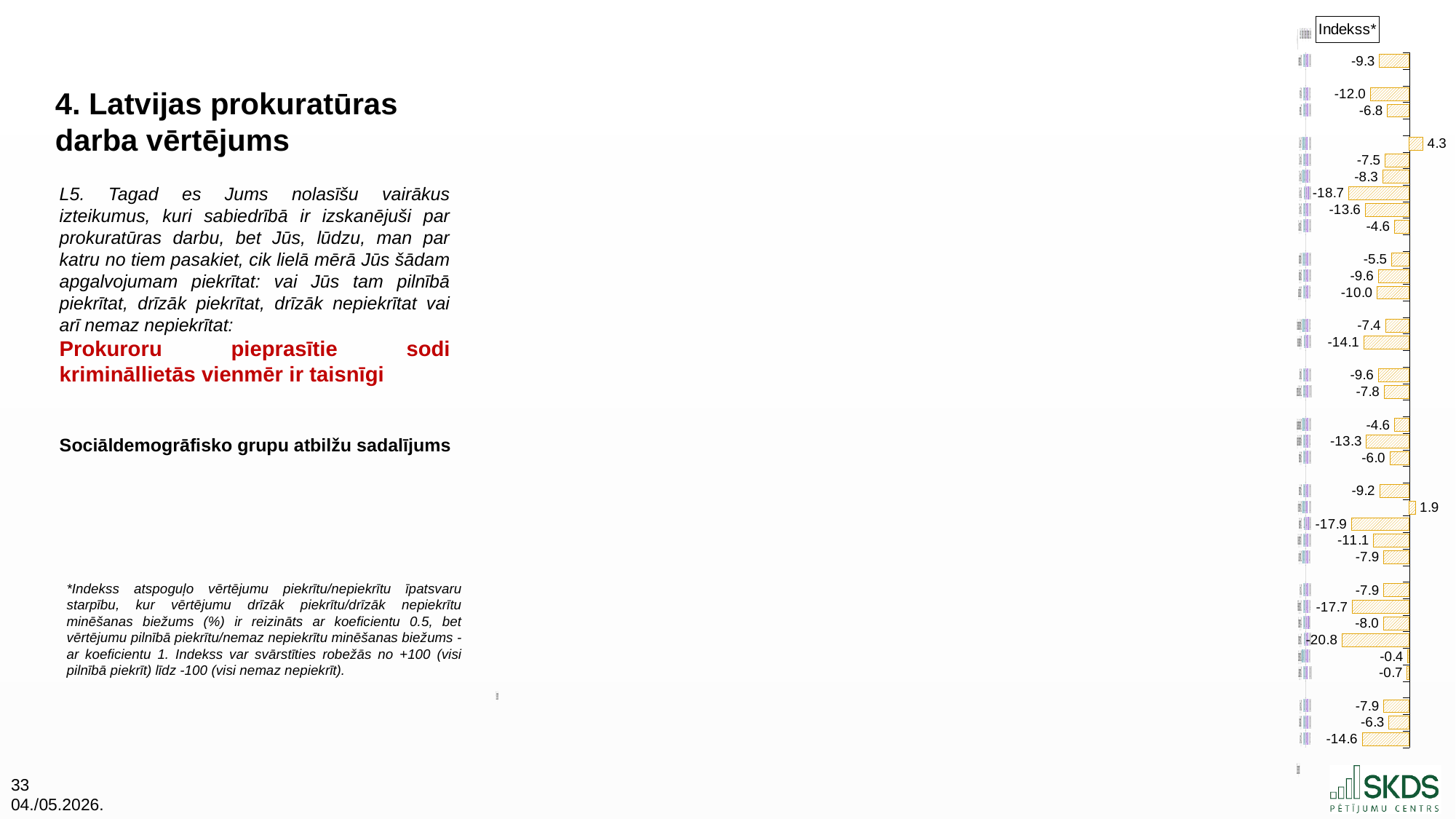
What is the highest index value shown in the chart? 4.3 Which is larger, the index value of the topmost bar (-9.3) or the bottommost bar (-14.6)? the topmost bar (-9.3) What is the lowest index value shown in the chart? -20.8 What is the index value of the topmost bar in the chart? -9.3 What is the second positive index value shown in the chart, below 4.3? 1.9 What kind of chart is shown on the right side of the slide? bar chart What is the title shown above the chart on the right? Indekss* What is the difference between the highest index value (4.3) and the lowest index value (-20.8) in the chart? 25.1 How many bars are plotted in the chart? 33 How many bars in the chart have a positive index value? 2 What is the index value of the bottommost bar in the chart? -14.6